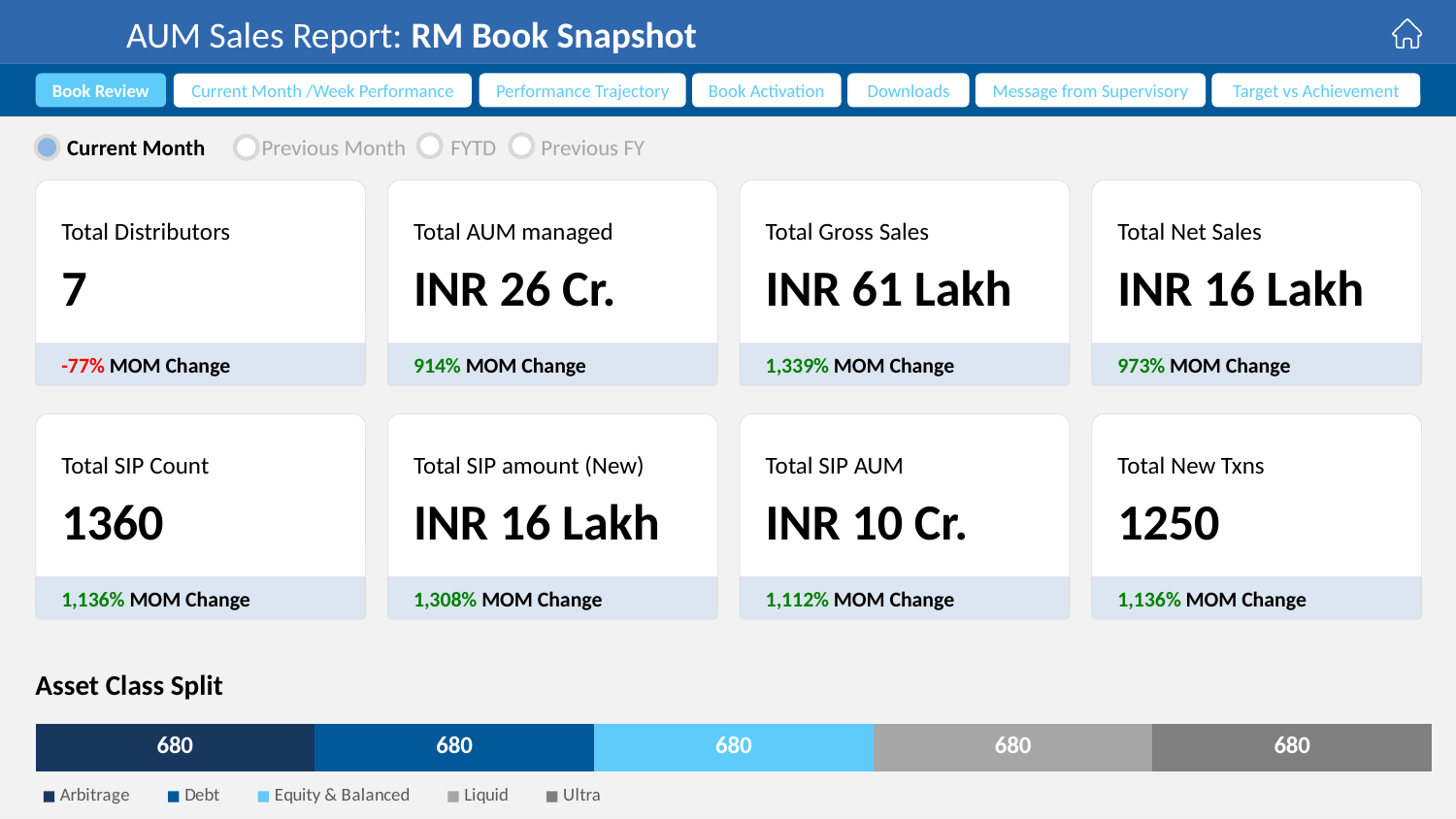
In the Asset Class Split chart, what is the value for Debt? 680 How many series does the legend of the Asset Class Split chart list? 5 In the Asset Class Split chart, what is the value for Arbitrage? 680 What kind of chart is the Asset Class Split chart? Stacked bar chart How many segments make up the stacked bar in the Asset Class Split chart? 5 In the Asset Class Split chart, what is the value for Ultra? 680 What is the title of the stacked bar chart on the slide? Asset Class Split What is the total of the stacked bar in the Asset Class Split chart? 3,400 In the Asset Class Split chart, what is the value for Equity & Balanced? 680 In the Asset Class Split chart, which legend entry is shown in light blue? Equity & Balanced In the Asset Class Split chart, what is the value for Liquid? 680 In the Asset Class Split chart, what is the difference between the Debt value and the Liquid value? 0